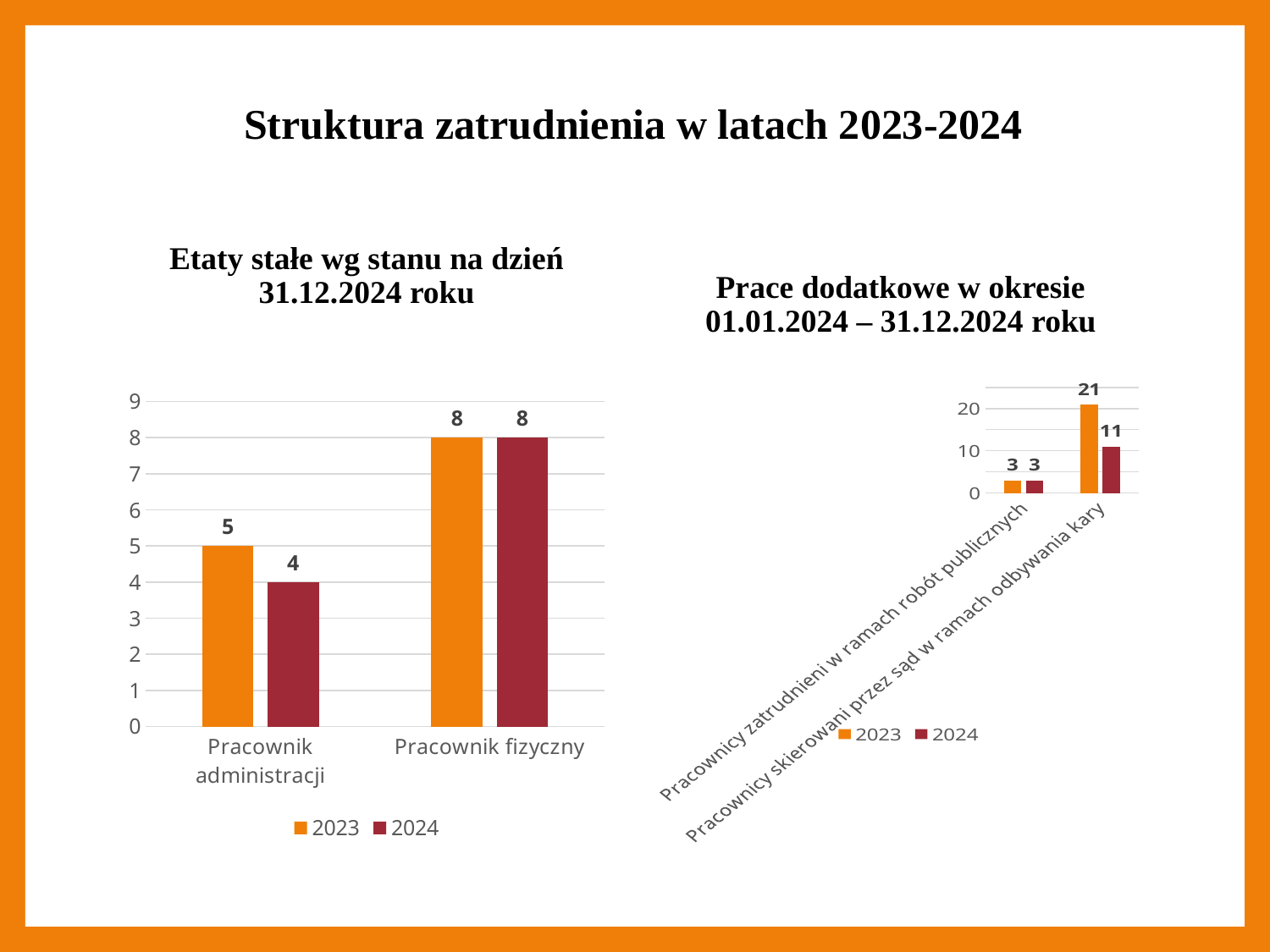
In the left chart 'Etaty stałe wg stanu na dzień 31.12.2024 roku', how many series does the legend list? 2 In the right chart 'Prace dodatkowe w okresie 01.01.2024 – 31.12.2024 roku', what is the 2023 value for Pracownicy skierowani przez sąd w ramach odbywania kary? 21 What type of chart is the right chart 'Prace dodatkowe w okresie 01.01.2024 – 31.12.2024 roku'? bar chart In the left chart 'Etaty stałe wg stanu na dzień 31.12.2024 roku', how many categories are shown on the x axis? 2 In the right chart 'Prace dodatkowe w okresie 01.01.2024 – 31.12.2024 roku', what is the difference between the 2023 and 2024 values for Pracownicy skierowani przez sąd w ramach odbywania kary? 10 In the left chart 'Etaty stałe wg stanu na dzień 31.12.2024 roku', which category has the higher value in 2023? Pracownik fizyczny In the left chart 'Etaty stałe wg stanu na dzień 31.12.2024 roku', what is the value for Pracownik administracji in 2024? 4 In the right chart 'Prace dodatkowe w okresie 01.01.2024 – 31.12.2024 roku', what is the 2024 value for Pracownicy skierowani przez sąd w ramach odbywania kary? 11 In the right chart 'Prace dodatkowe w okresie 01.01.2024 – 31.12.2024 roku', which category has the highest value? Pracownicy skierowani przez sąd w ramach odbywania kary In the left chart 'Etaty stałe wg stanu na dzień 31.12.2024 roku', what is the value for Pracownik administracji in 2023? 5 In the left chart 'Etaty stałe wg stanu na dzień 31.12.2024 roku', what is the value for Pracownik fizyczny in 2024? 8 In the left chart 'Etaty stałe wg stanu na dzień 31.12.2024 roku', what is the difference between the 2023 and 2024 values for Pracownik administracji? 1